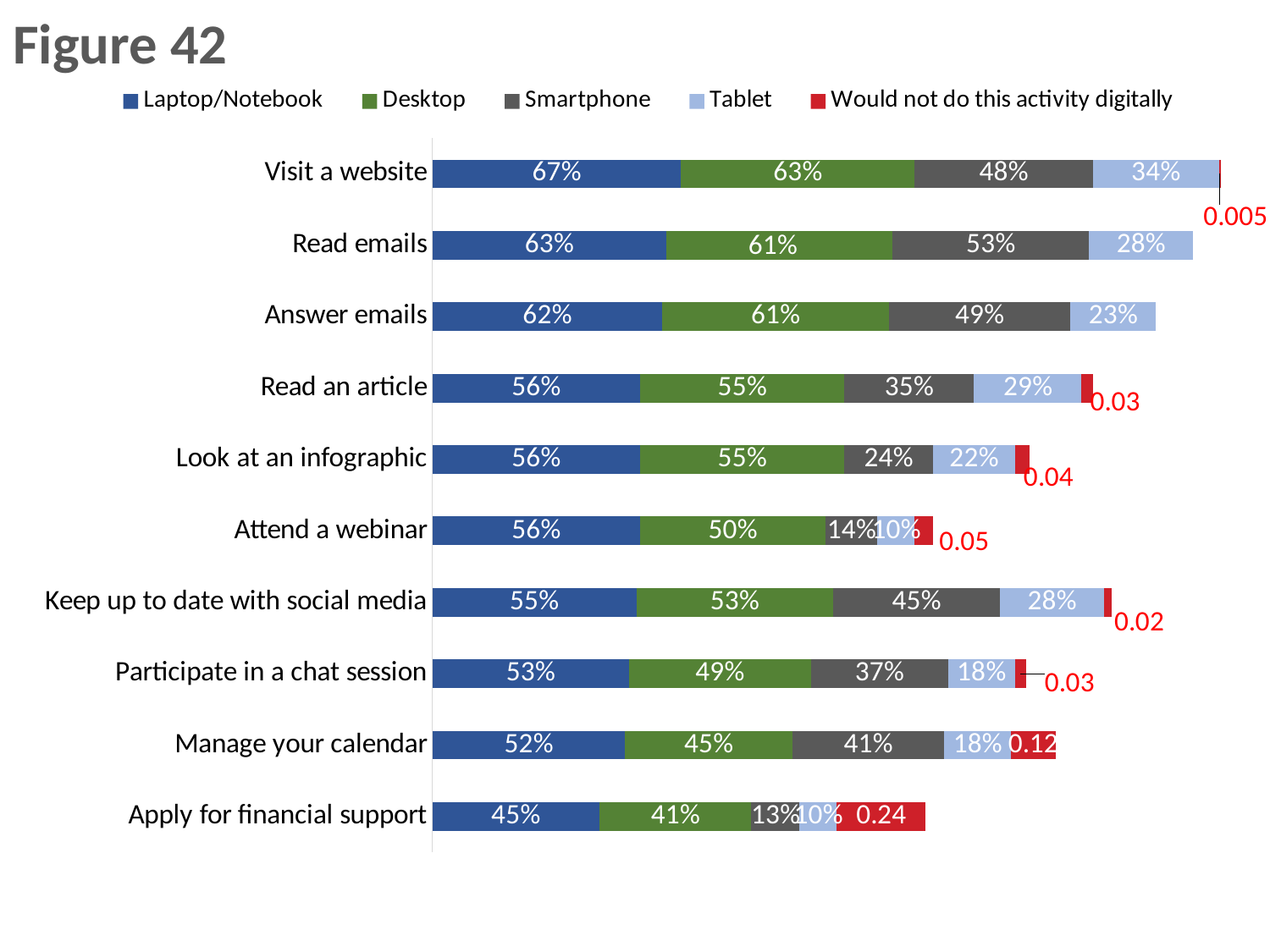
What is the Tablet value for "Answer emails"? 23% What is the Laptop/Notebook value for "Visit a website"? 67% How many activities are listed on the chart? 10 Which has the larger Smartphone value: "Read an article" or "Look at an infographic"? Read an article Which activity has the lowest Laptop/Notebook value? Apply for financial support What is the "Would not do this activity digitally" value for "Manage your calendar"? 0.12 What is the difference between the Laptop/Notebook and Desktop values for "Visit a website"? 4 percentage points What kind of chart is shown on the slide? Stacked bar chart What is the Smartphone value for "Read emails"? 53% Which activity has the highest Laptop/Notebook value? Visit a website What is the Desktop value for "Apply for financial support"? 41% How many series does the legend list? 5